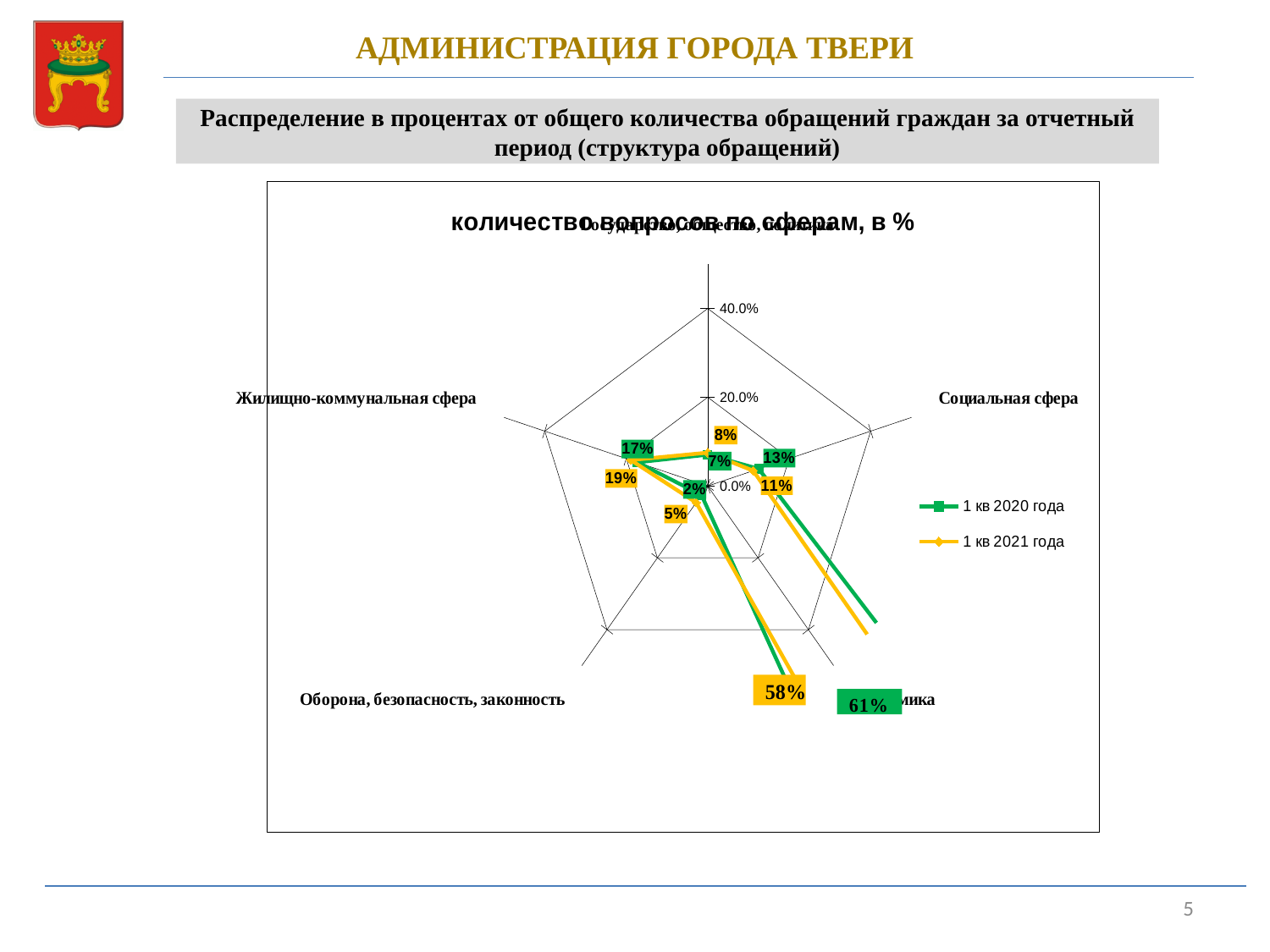
What is the value for Жилищно-коммунальная сфера in the 1 кв 2021 года series? 19% What type of chart is shown on the slide? Radar chart What is the value for Жилищно-коммунальная сфера in the 1 кв 2020 года series? 17% What is the value for Оборона, безопасность, законность in the 1 кв 2020 года series? 2% What is the value for Социальная сфера in the 1 кв 2020 года series? 13% Which series has the larger value for Социальная сфера, 1 кв 2020 года or 1 кв 2021 года? 1 кв 2020 года What is the highest value shown for the 1 кв 2021 года series? 58% What is the value for Оборона, безопасность, законность in the 1 кв 2021 года series? 5% How many series does the chart legend list? 2 What is the highest value shown for the 1 кв 2020 года series? 61% What is the value for Социальная сфера in the 1 кв 2021 года series? 11% What is the difference between the 1 кв 2021 года and 1 кв 2020 года values for Жилищно-коммунальная сфера? 2%